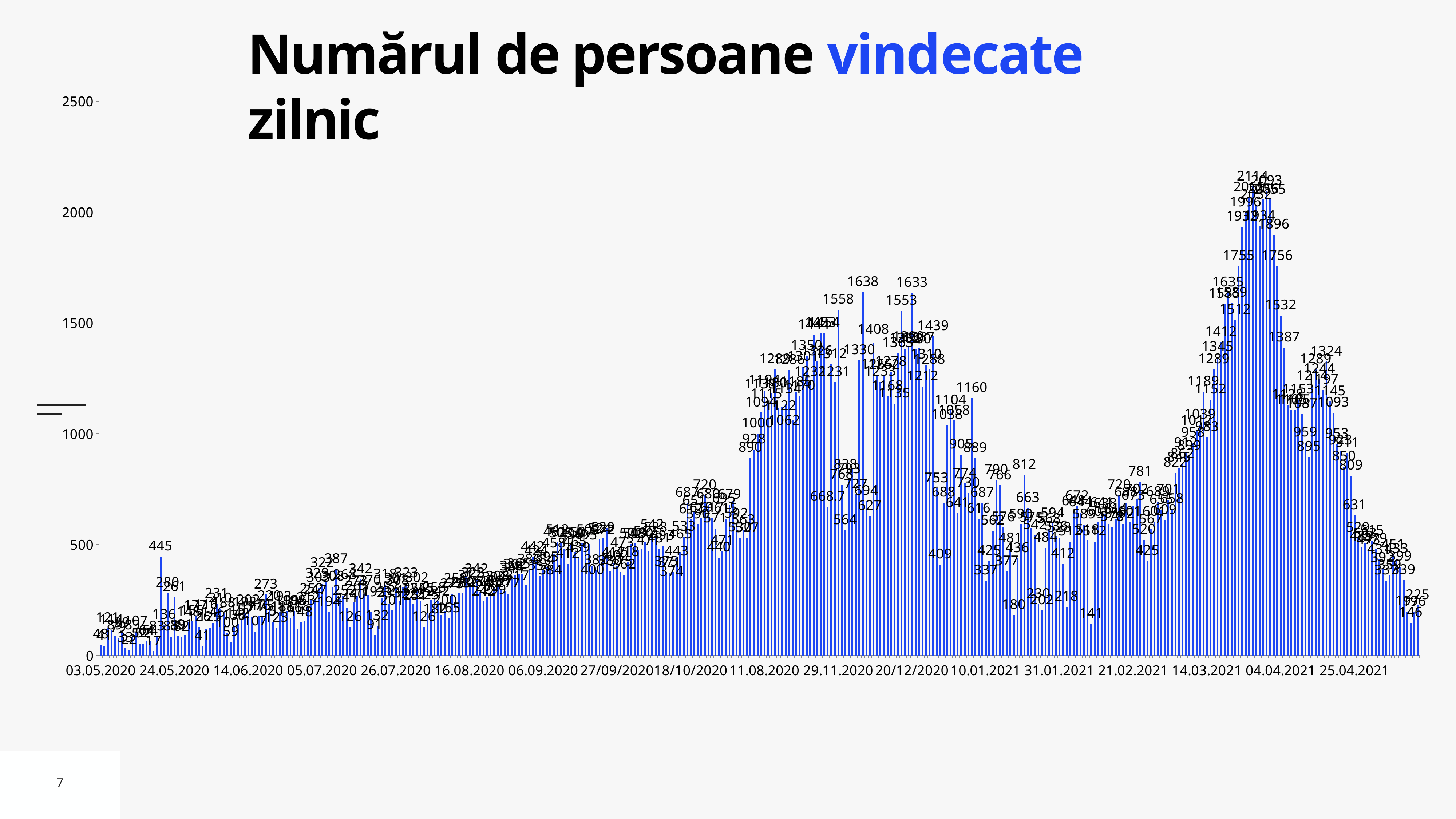
Do the values generally rise or fall between 04.04.2021 and 25.04.2021? fall What is the first date shown on the horizontal axis? 03.05.2020 Is the highest value on the chart greater or less than 2000? greater What is the value of the tallest bar in May 2020? 445 What is the maximum value shown on the vertical axis? 2500 What is the value of the first bar, at 03.05.2020? 48 What is the highest value labelled on the chart? 2114 Which peak is higher: the tallest bar near 29.11.2020 or the tallest bar near 04.04.2021? the one near 04.04.2021 What is the title of the chart? Numărul de persoane vindecate zilnic Is the value for 03.05.2020 greater or less than 500? less What is the last date label shown on the horizontal axis? 25.04.2021 What kind of chart is shown on the slide? bar chart